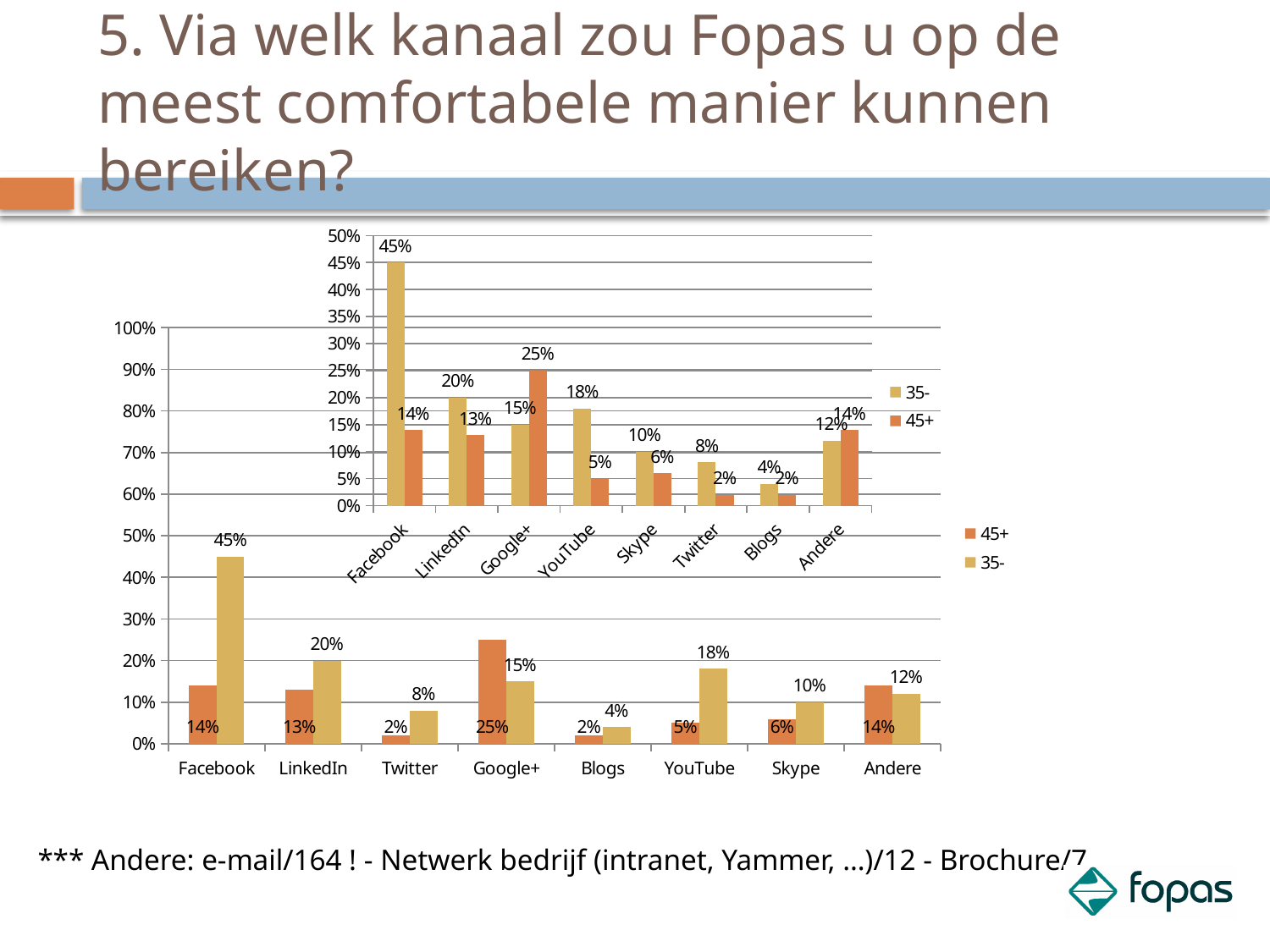
In the larger chart at the bottom of the slide, which category has the highest value in the 35- series? Facebook In the larger chart at the bottom of the slide, what is the difference between the 35- and 45+ values for Facebook? 31% In the larger chart at the bottom of the slide, which category has the highest value in the 45+ series? Google+ In the larger chart at the bottom of the slide, which colour represents the 45+ series? Orange In the larger chart at the bottom of the slide, how many categories are shown on the x axis? 8 In the smaller chart at the top of the slide, how many series does the legend list? 2 In the larger chart at the bottom of the slide, what is the value for Facebook in the 35- series? 45% In the larger chart at the bottom of the slide, which is larger for Skype: the 35- value or the 45+ value? 35- In the larger chart at the bottom of the slide, what is the value for Google+ in the 45+ series? 25% In the smaller chart at the top of the slide, which category has the lowest value in the 35- series? Blogs In the smaller chart at the top of the slide, what is the value for YouTube in the 35- series? 18% What kind of chart is the larger chart at the bottom of the slide? Bar chart